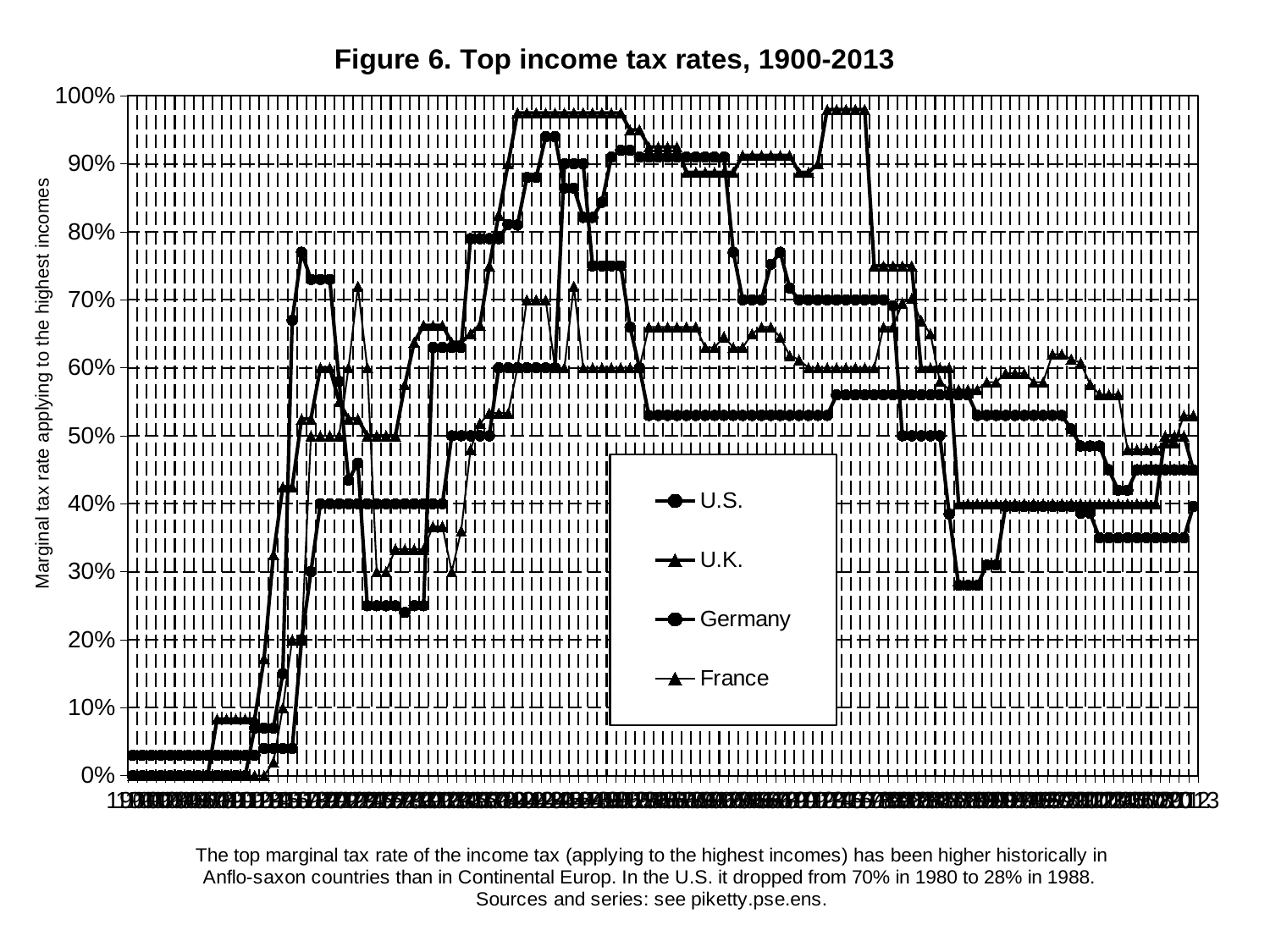
Is the highest value plotted on the chart greater or less than 90%? greater How many series does the legend list? 4 Do the top income tax rates generally rise or fall between 1900 and the 1940s? rise What is the highest tick value on the vertical axis? 100% What is the label of the vertical axis? Marginal tax rate applying to the highest incomes Which countries are listed in the legend? U.S., U.K., Germany, France At the start of the period (1900), are the values for all four series greater or less than 10%? less According to the caption, what was the U.S. top marginal tax rate in 1988? 28% What kind of chart is shown on the slide? line chart What is the first year shown on the horizontal axis? 1900 What is the last year shown on the horizontal axis? 2013 What is the title of the chart? Figure 6. Top income tax rates, 1900-2013